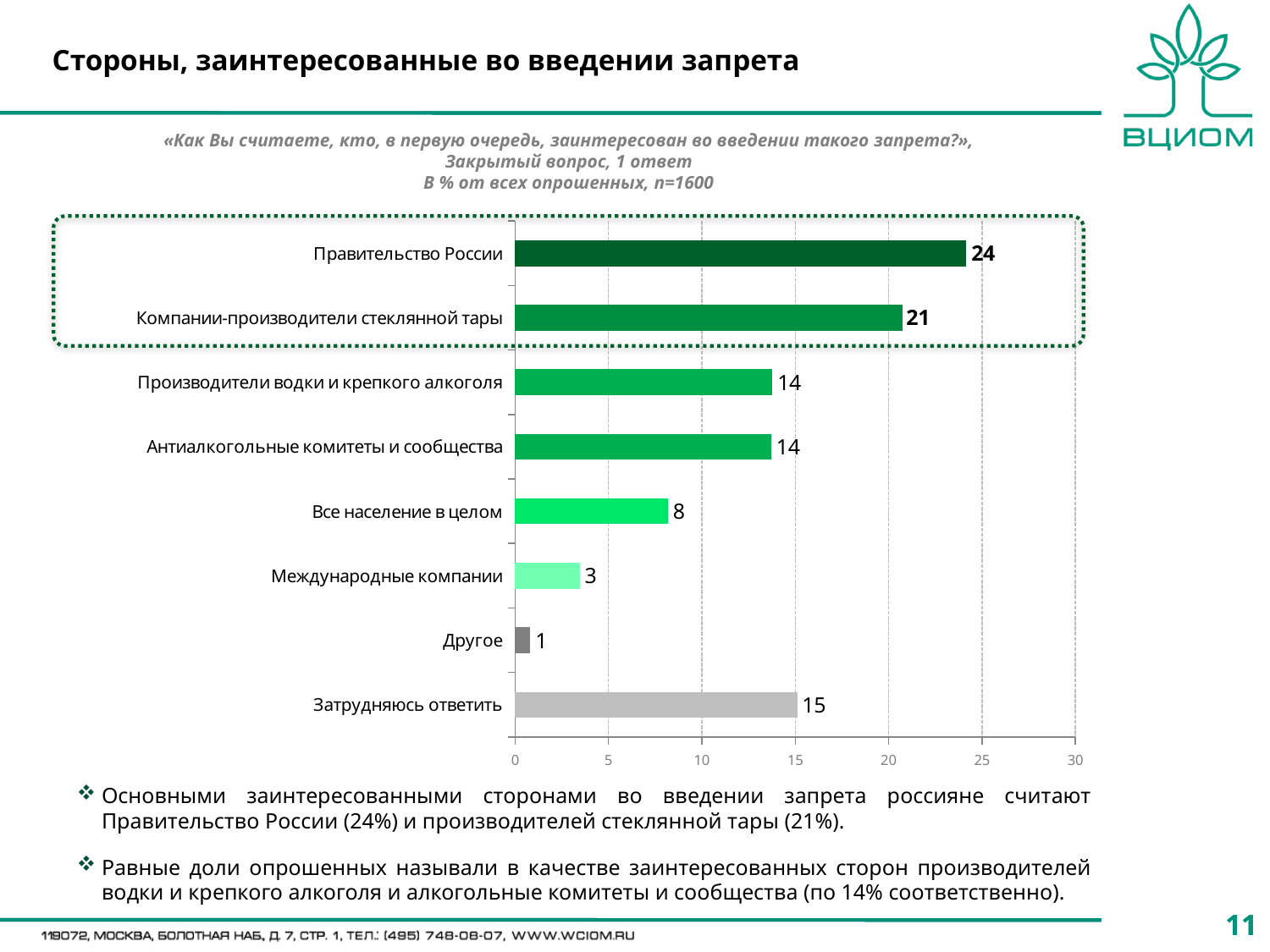
What is the value for Затрудняюсь ответить? 15 What is the value for Международные компании? 3 What kind of chart is shown on the slide? bar chart Which category has the highest value? Правительство России What is the difference between the values for Правительство России and Компании-производители стеклянной тары? 3 Which category has the lowest value? Другое What is the sample size (n) stated in the chart subtitle? n=1600 Is the value for Производители водки и крепкого алкоголя greater or less than 10? greater What is the value for Правительство России? 24 How many categories are shown in the chart? 8 Which is larger: the value for Все население в целом or the value for Затрудняюсь ответить? Затрудняюсь ответить What is the value for Компании-производители стеклянной тары? 21